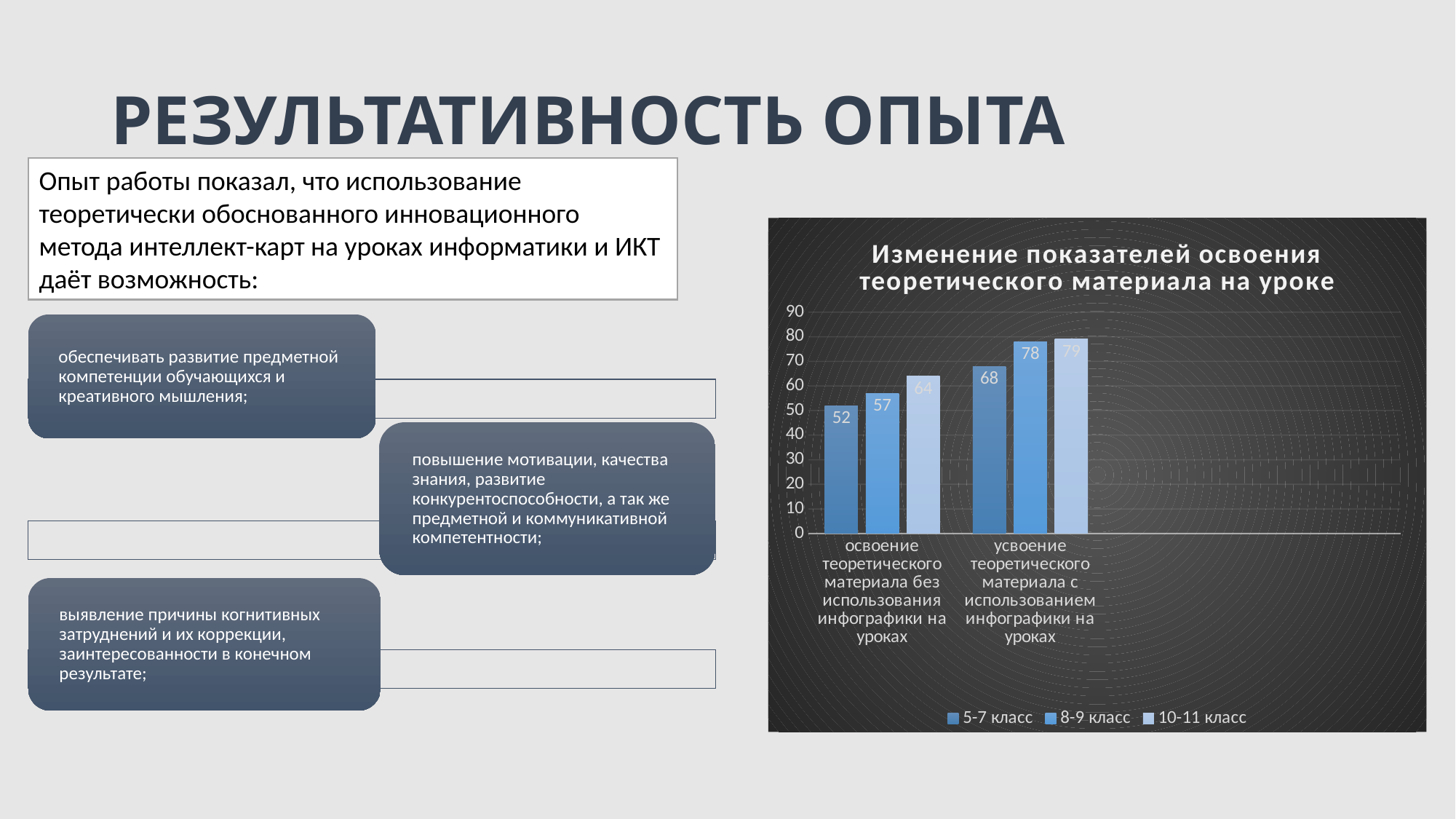
What is the difference between the 10-11 класс and 5-7 класс values in the category 'освоение теоретического материала без использования инфографики на уроках'? 12 Which is larger: the 5-7 класс value with infographics or the 10-11 класс value without infographics? 5-7 класс value with infographics What is the difference between the 8-9 класс values for the two categories? 21 What is the value for 10-11 класс in the category 'усвоение теоретического материала с использованием инфографики на уроках'? 79 How many categories are shown on the x axis of the chart? 2 Which series has the lowest value in the category 'освоение теоретического материала без использования инфографики на уроках'? 5-7 класс Which series has the highest value in the category 'усвоение теоретического материала с использованием инфографики на уроках'? 10-11 класс What is the value for 8-9 класс in the category 'освоение теоретического материала без использования инфографики на уроках'? 57 What type of chart is shown on the slide? Bar chart What is the value for 5-7 класс in the category 'освоение теоретического материала без использования инфографики на уроках'? 52 How many series does the chart legend list? 3 What is the title of the chart? Изменение показателей освоения теоретического материала на уроке